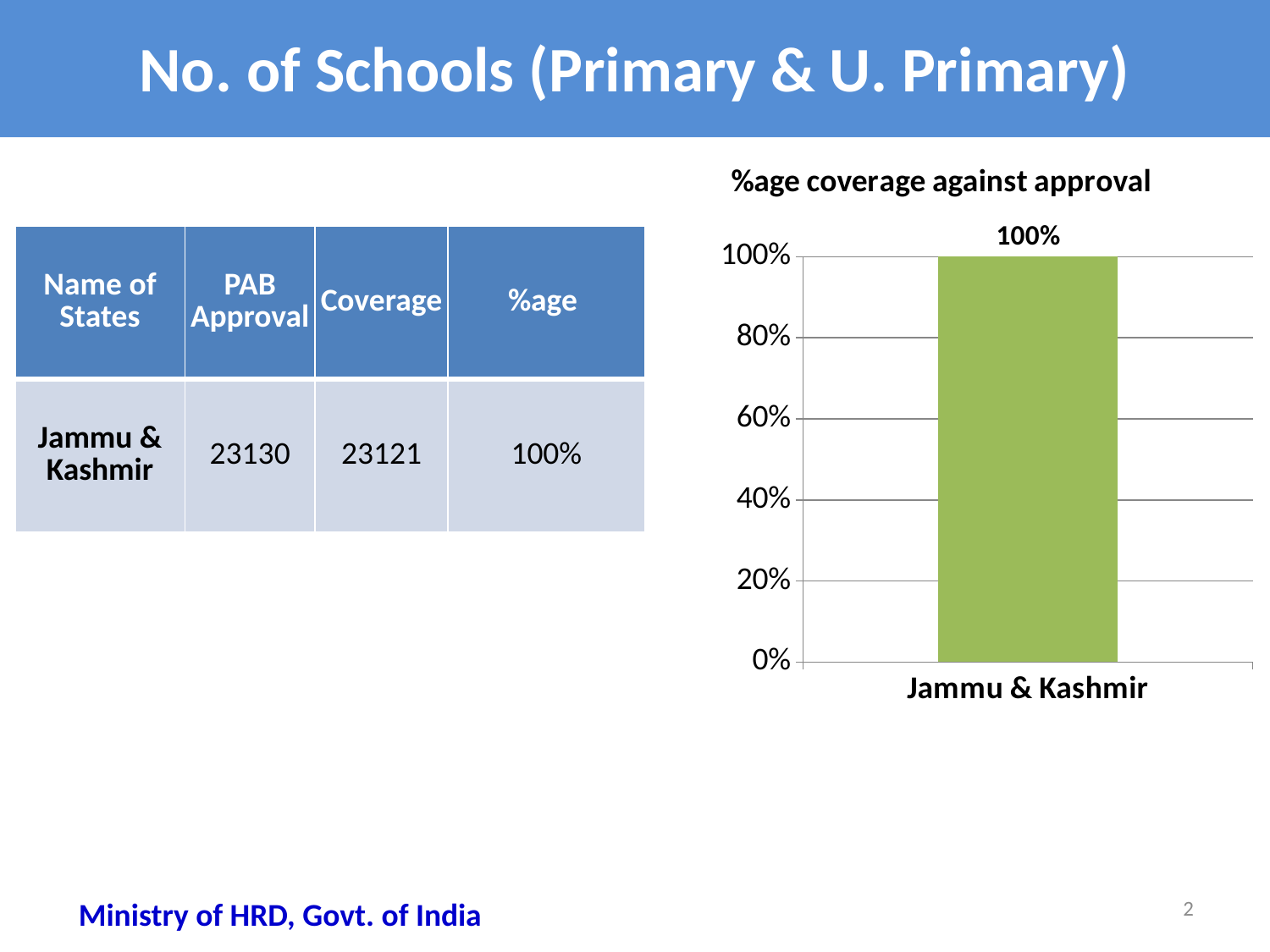
What kind of chart is shown on the slide? bar chart What is the title of the chart? %age coverage against approval What is the value shown for Jammu & Kashmir in the chart? 100% How many categories are plotted in the chart? 1 What is the highest value shown on the chart's y axis? 100% Is the value for Jammu & Kashmir greater or less than 80%? greater Which category is shown on the x axis of the chart? Jammu & Kashmir